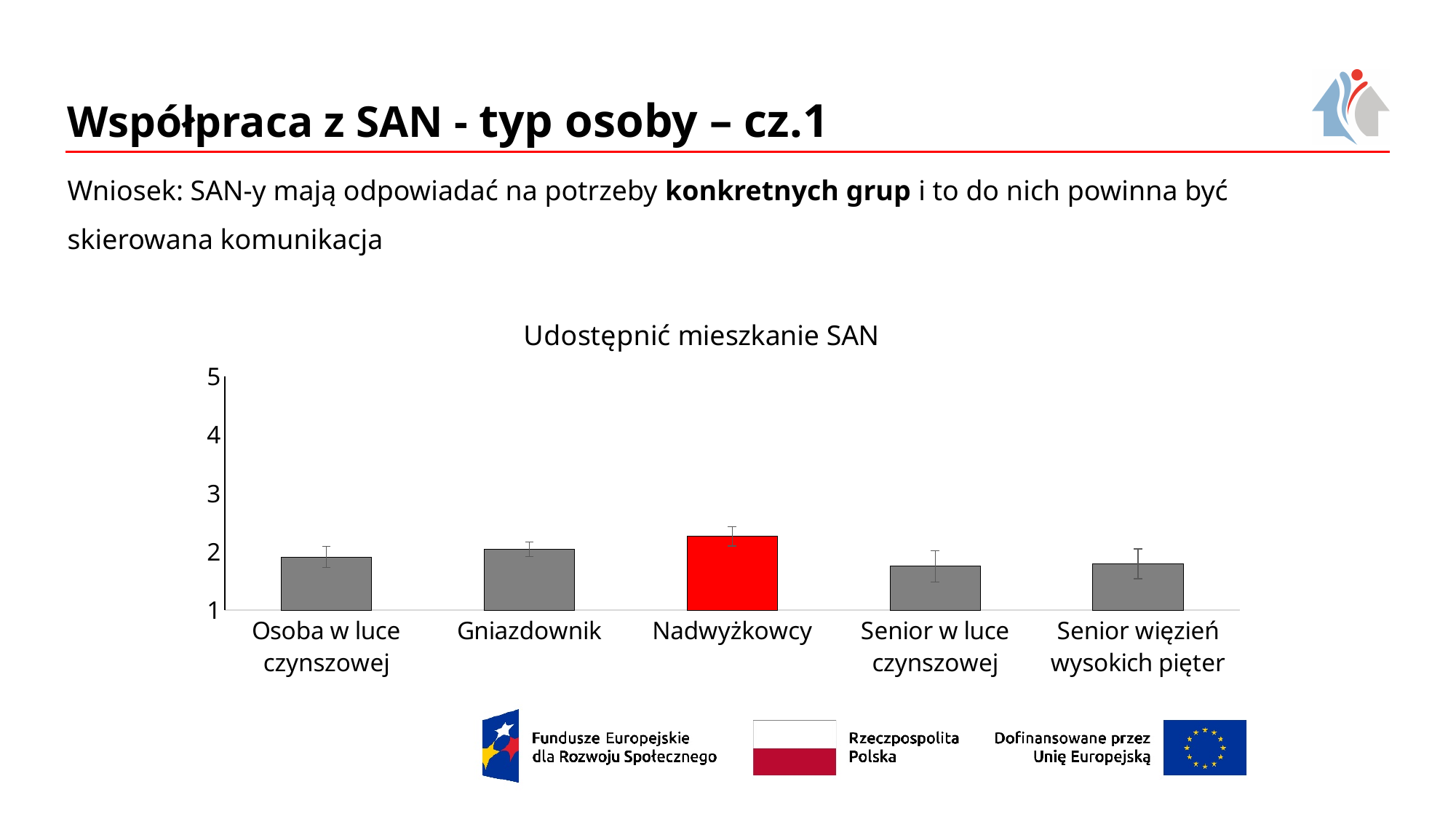
Is the value for Nadwyżkowcy greater or less than 2? greater Which is larger, the value for Nadwyżkowcy or the value for Senior w luce czynszowej? Nadwyżkowcy What type of chart is shown on the slide? bar chart What is the highest value shown on the y axis of the chart? 5 Which category's bar is coloured red in the chart? Nadwyżkowcy Is the value for Senior w luce czynszowej greater or less than 2? less What is the title of the chart? Udostępnić mieszkanie SAN Is the value for Nadwyżkowcy greater or less than 3? less Which is larger, the value for Gniazdownik or the value for Senior w luce czynszowej? Gniazdownik How many categories are shown on the x axis of the chart? 5 Which category has the highest bar in the chart? Nadwyżkowcy